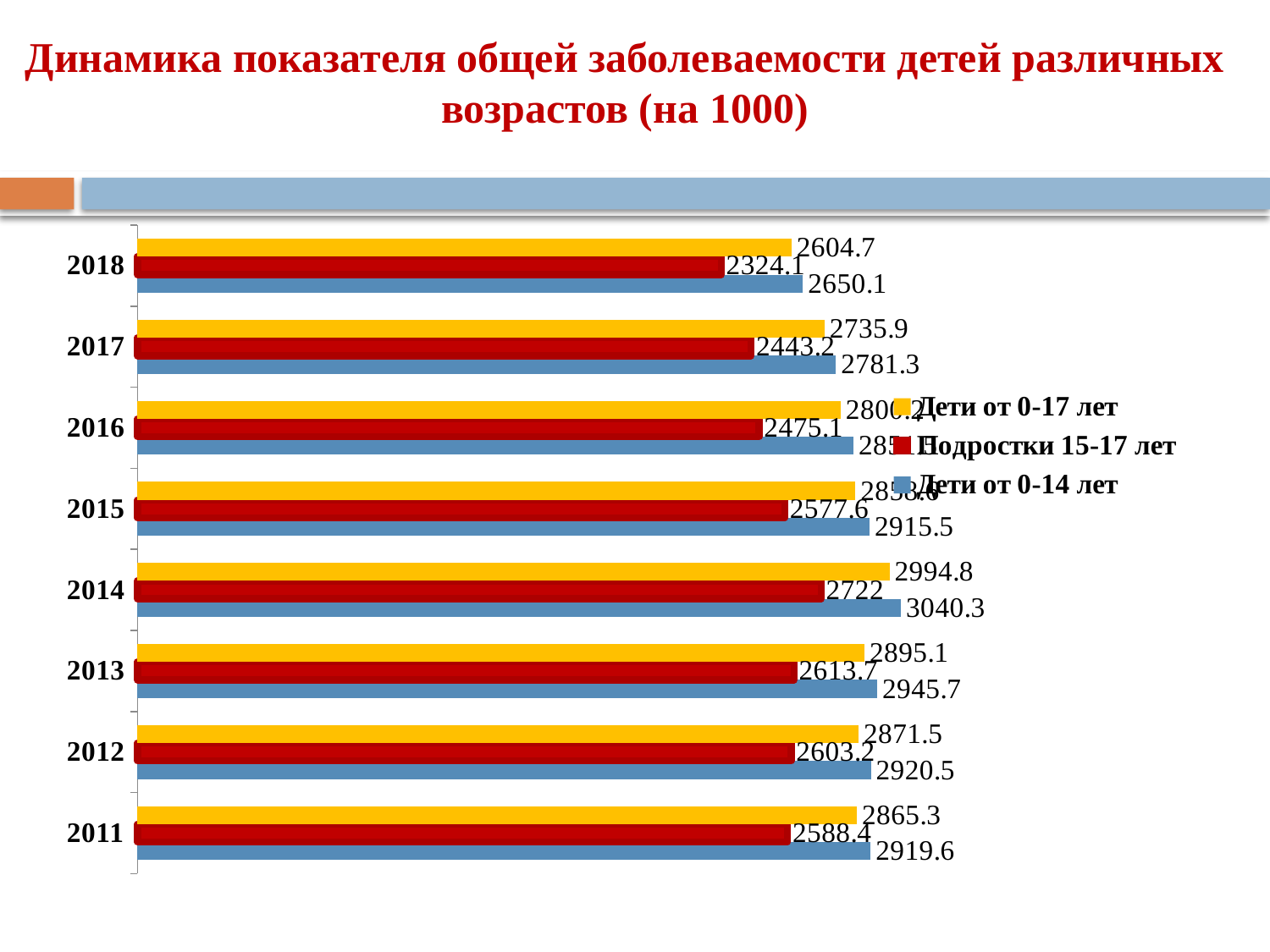
What kind of chart is shown on the slide? bar chart Which is larger for Дети от 0-17 лет: the value in 2013 or in 2012? 2013 How many series does the legend list? 3 In which year is the value for Дети от 0-14 лет highest? 2014 What is the value for Дети от 0-17 лет in 2011? 2865.3 What is the value for Дети от 0-14 лет in 2014? 3040.3 What is the value for Подростки 15-17 лет in 2018? 2324.1 How many years are shown on the chart? 8 What is the difference between the Дети от 0-17 лет values for 2011 and 2018? 260.6 Do the values for Подростки 15-17 лет rise or fall from 2014 to 2018? fall What is the difference between Дети от 0-14 лет and Подростки 15-17 лет in 2014? 318.3 In which year is the value for Подростки 15-17 лет lowest? 2018